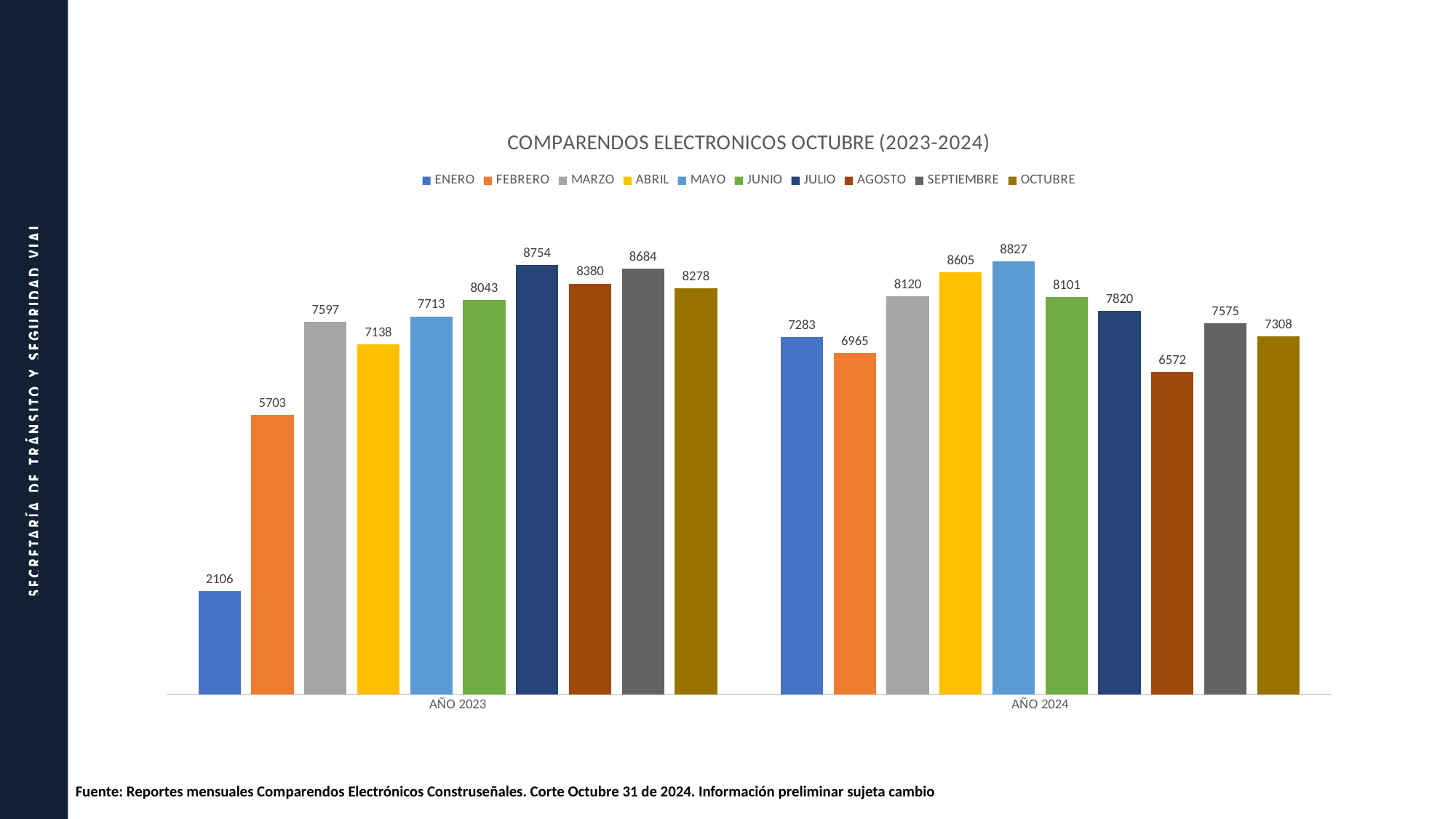
Which month has the lowest value in AÑO 2024? AGOSTO Which is larger, the SEPTIEMBRE value for AÑO 2023 or for AÑO 2024? AÑO 2023 What is the difference between the OCTUBRE values for AÑO 2023 and AÑO 2024? 970 What is the value for AGOSTO in AÑO 2024? 6572 What is the difference between the ENERO values for AÑO 2024 and AÑO 2023? 5177 What kind of chart is shown? Bar chart What is the value for MAYO in AÑO 2024? 8827 How many categories are shown on the x axis? 2 What is the title of the chart? COMPARENDOS ELECTRONICOS OCTUBRE (2023-2024) How many series does the legend list? 10 What is the value for ENERO in AÑO 2023? 2106 Which month has the highest value in AÑO 2023? JULIO